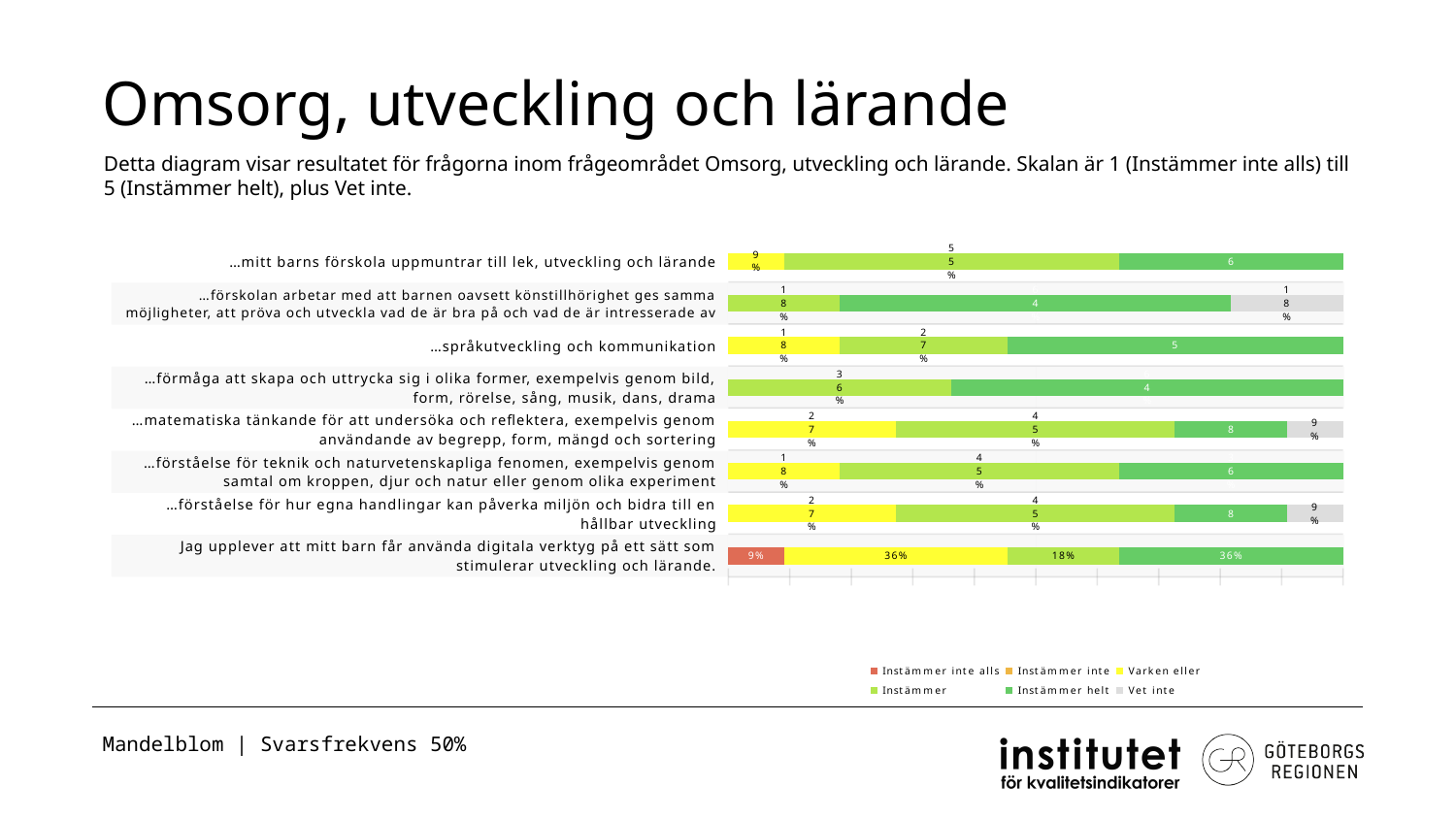
For 'Jag upplever att mitt barn får använda digitala verktyg...', which is larger: 'Varken eller' or 'Instämmer'? Varken eller What is the value of 'Varken eller' for '…mitt barns förskola uppmuntrar till lek, utveckling och lärande'? 9% How many categories (questions) are plotted in the chart? 8 How many series does the chart legend list? 6 Which legend entry is shown in red? Instämmer inte alls For 'Jag upplever att mitt barn får använda digitala verktyg...', what is the difference between 'Varken eller' (36%) and 'Instämmer' (18%)? 18% What kind of chart is shown on the slide? Stacked bar chart What is the value of 'Instämmer inte alls' for 'Jag upplever att mitt barn får använda digitala verktyg på ett sätt som stimulerar utveckling och lärande.'? 9% What is the value of 'Varken eller' for 'Jag upplever att mitt barn får använda digitala verktyg på ett sätt som stimulerar utveckling och lärande.'? 36% What is the value of 'Instämmer helt' for 'Jag upplever att mitt barn får använda digitala verktyg på ett sätt som stimulerar utveckling och lärande.'? 36% What is the value of 'Instämmer' for 'Jag upplever att mitt barn får använda digitala verktyg på ett sätt som stimulerar utveckling och lärande.'? 18% What is the value of 'Instämmer' for '…språkutveckling och kommunikation'? 27%